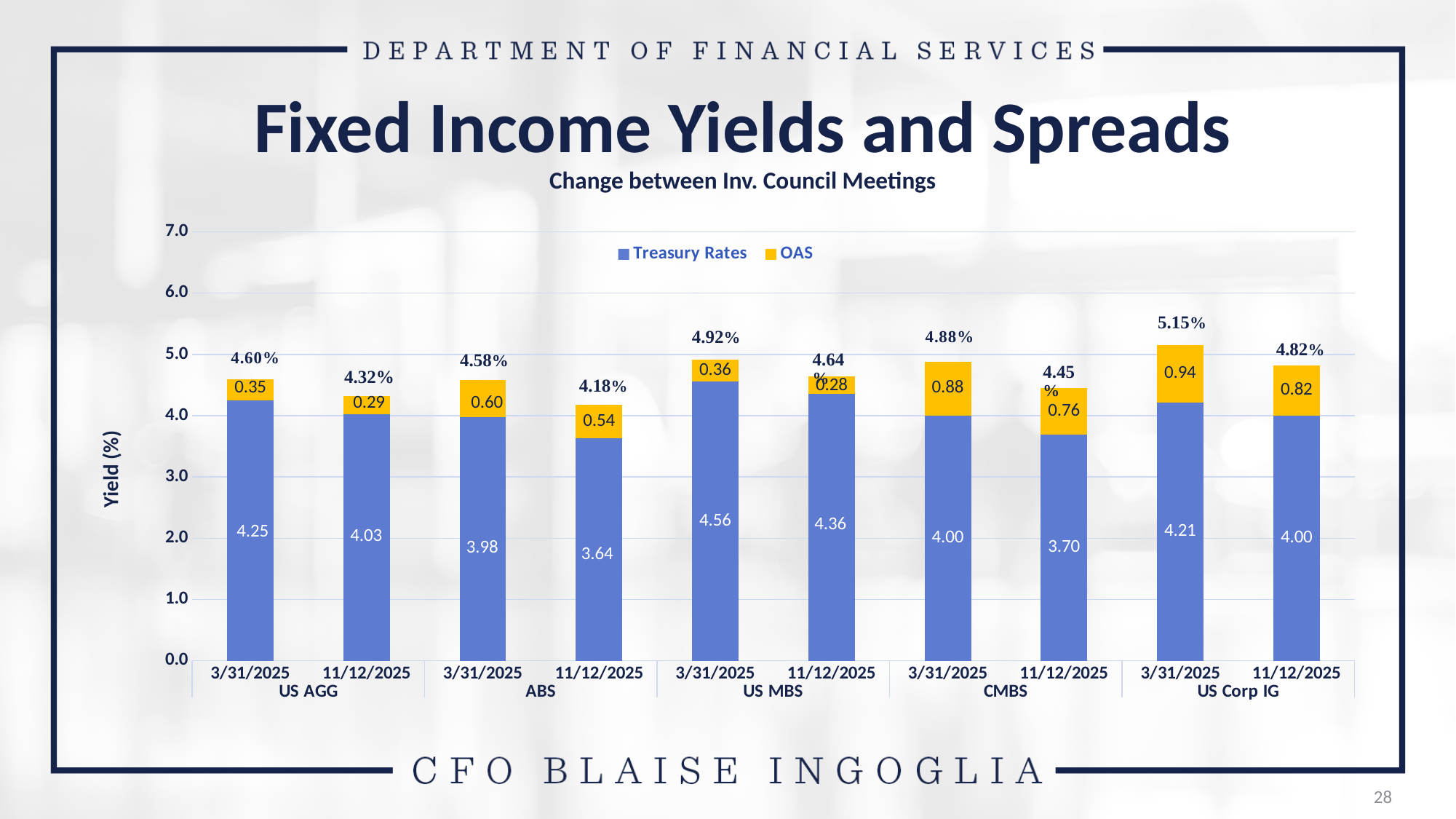
How many bars are plotted in the chart? 10 What kind of chart is shown on the slide? Stacked bar chart Which is larger, the OAS value for CMBS on 3/31/2025 or the OAS value for US Corp IG on 11/12/2025? CMBS on 3/31/2025 How many series does the legend list? 2 Which bar has the highest total yield? US Corp IG 3/31/2025 Is the total yield for ABS on 11/12/2025 greater or less than 5.0? less What is the total of the stacked bar for US AGG on 11/12/2025? 4.32% What is the Treasury Rates value for US AGG on 3/31/2025? 4.25 What is the OAS value for CMBS on 11/12/2025? 0.76 What is the difference between the Treasury Rates value for US MBS on 3/31/2025 and on 11/12/2025? 0.20 What is the total yield shown above the US Corp IG bar for 3/31/2025? 5.15% Which bar has the lowest total yield? ABS 11/12/2025